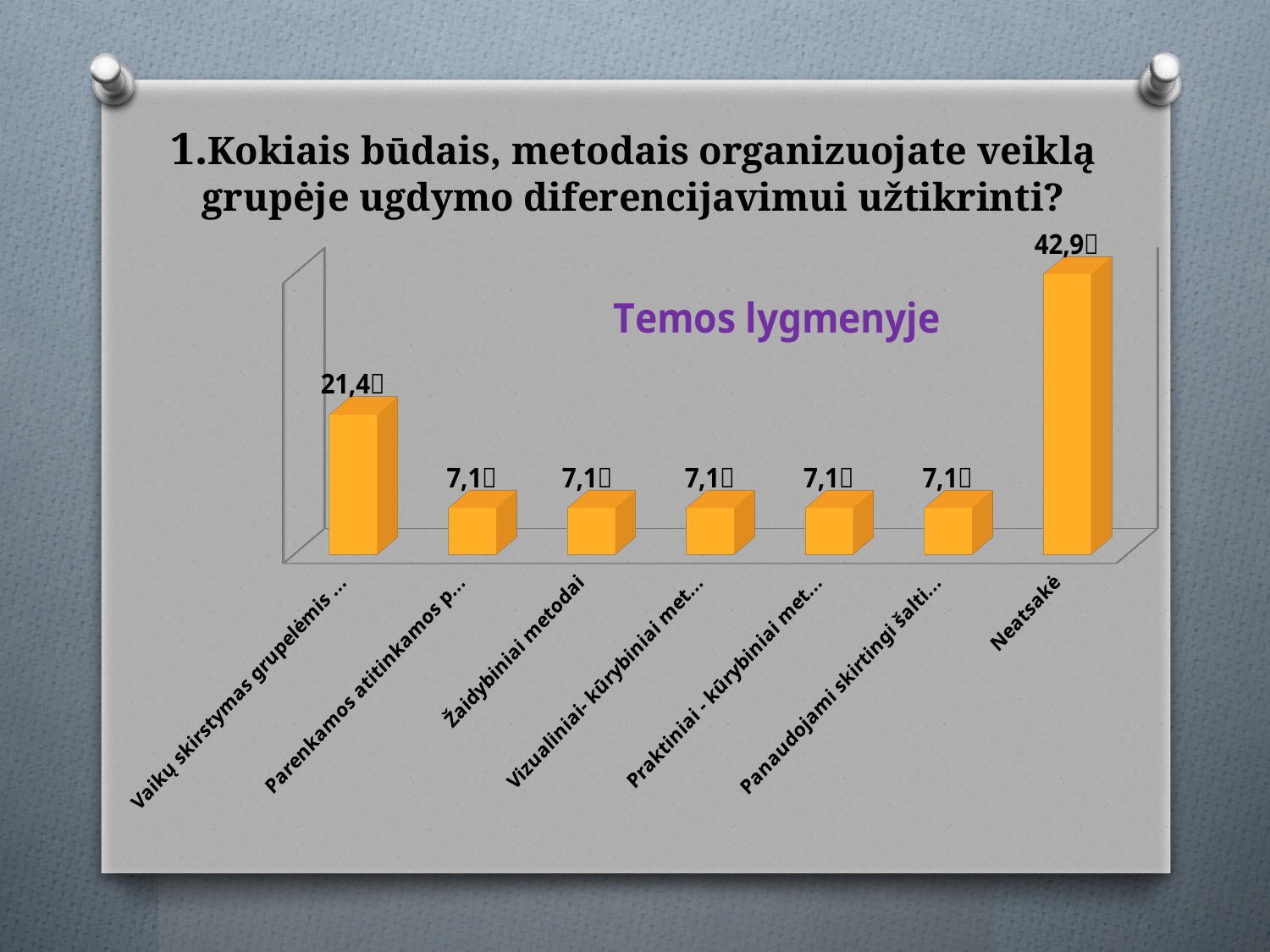
What is the difference between the value for 'Neatsakė' and the value for the category beginning 'Vaikų skirstymas grupelėmis'? 21,5 What is the value for the category 'Žaidybiniai metodai'? 7,1 What is the title of the chart? Temos lygmenyje What is the difference between the value for the category beginning 'Vaikų skirstymas grupelėmis' and the value for 'Žaidybiniai metodai'? 14,3 What is the value for the category beginning 'Vaikų skirstymas grupelėmis'? 21,4 What is the value for the category 'Neatsakė'? 42,9 How many categories have the value 7,1? 5 What colour are the bars in the chart? orange Which category has the highest value? Neatsakė How many categories are plotted in the chart? 7 What kind of chart is shown on the slide? bar chart Which is larger: the value for 'Neatsakė' or the value for the category beginning 'Vaikų skirstymas grupelėmis'? Neatsakė